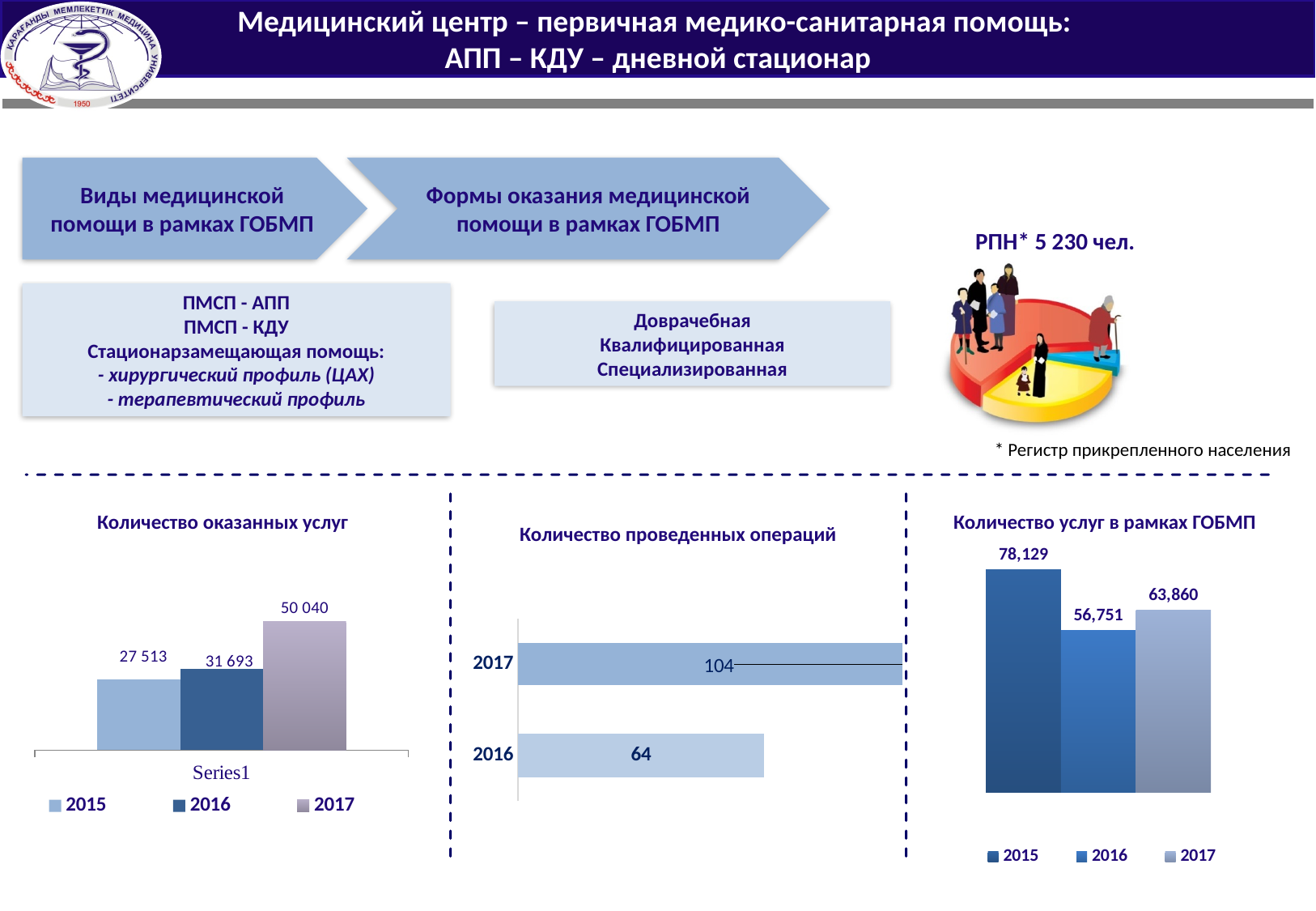
In the chart 'Количество услуг в рамках ГОБМП', what is the value for 2016? 56,751 What kind of chart is 'Количество проведенных операций'? bar chart In the chart 'Количество оказанных услуг', what is the value for 2015? 27 513 In the chart 'Количество оказанных услуг', do the values rise or fall from 2015 to 2017? rise In the chart 'Количество оказанных услуг', which year has the highest value? 2017 How many series does the legend of the chart 'Количество услуг в рамках ГОБМП' list? 3 In the chart 'Количество услуг в рамках ГОБМП', which year has the lowest value? 2016 In the chart 'Количество услуг в рамках ГОБМП', which is larger, the value for 2015 or the value for 2017? 2015 In the chart 'Количество проведенных операций', what is the difference between the 2017 and 2016 values? 40 In the chart 'Количество проведенных операций', what is the value for 2016? 64 In the chart 'Количество оказанных услуг', what is the value for 2017? 50 040 In the chart 'Количество оказанных услуг', what is the difference between the 2017 and 2016 values? 18 347